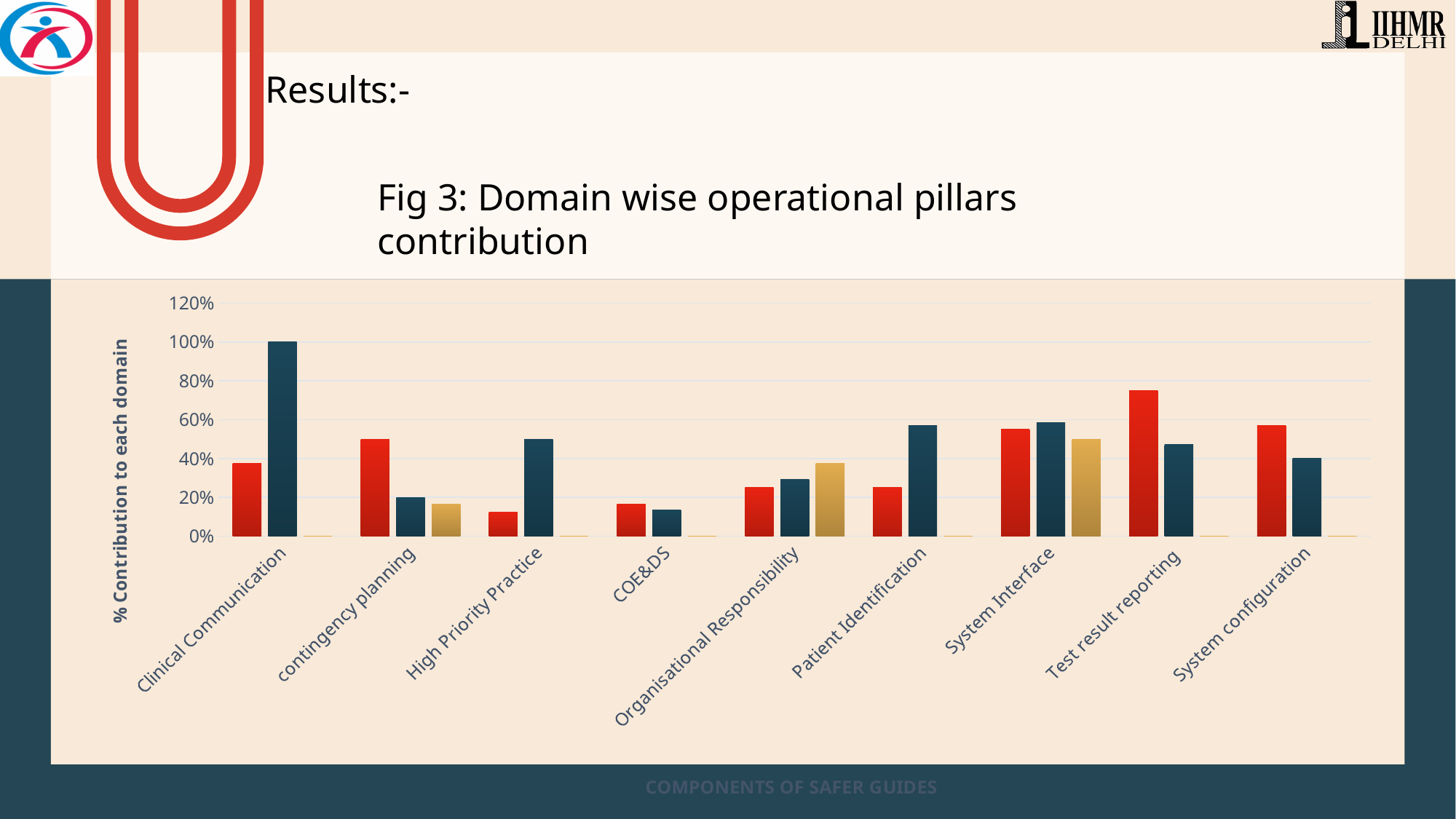
Which domain has the tallest bar in the chart? Clinical Communication What is the value of the dark teal bar for contingency planning? 20% Which domain has the tallest red bar? Test result reporting What is the title of the y axis of the chart? % Contribution to each domain Is the red bar for Test result reporting greater or less than 60%? greater How many domain categories are shown along the x axis of the chart? 9 Is the red bar for High Priority Practice greater or less than 20%? less For Clinical Communication, which is larger: the red bar or the dark teal bar? the dark teal bar Is the dark teal bar for Patient Identification greater or less than 40%? greater What is the value of the dark teal bar for System configuration? 40% What is the value of the dark teal bar for Clinical Communication? 100% What type of chart is shown on the slide? bar chart